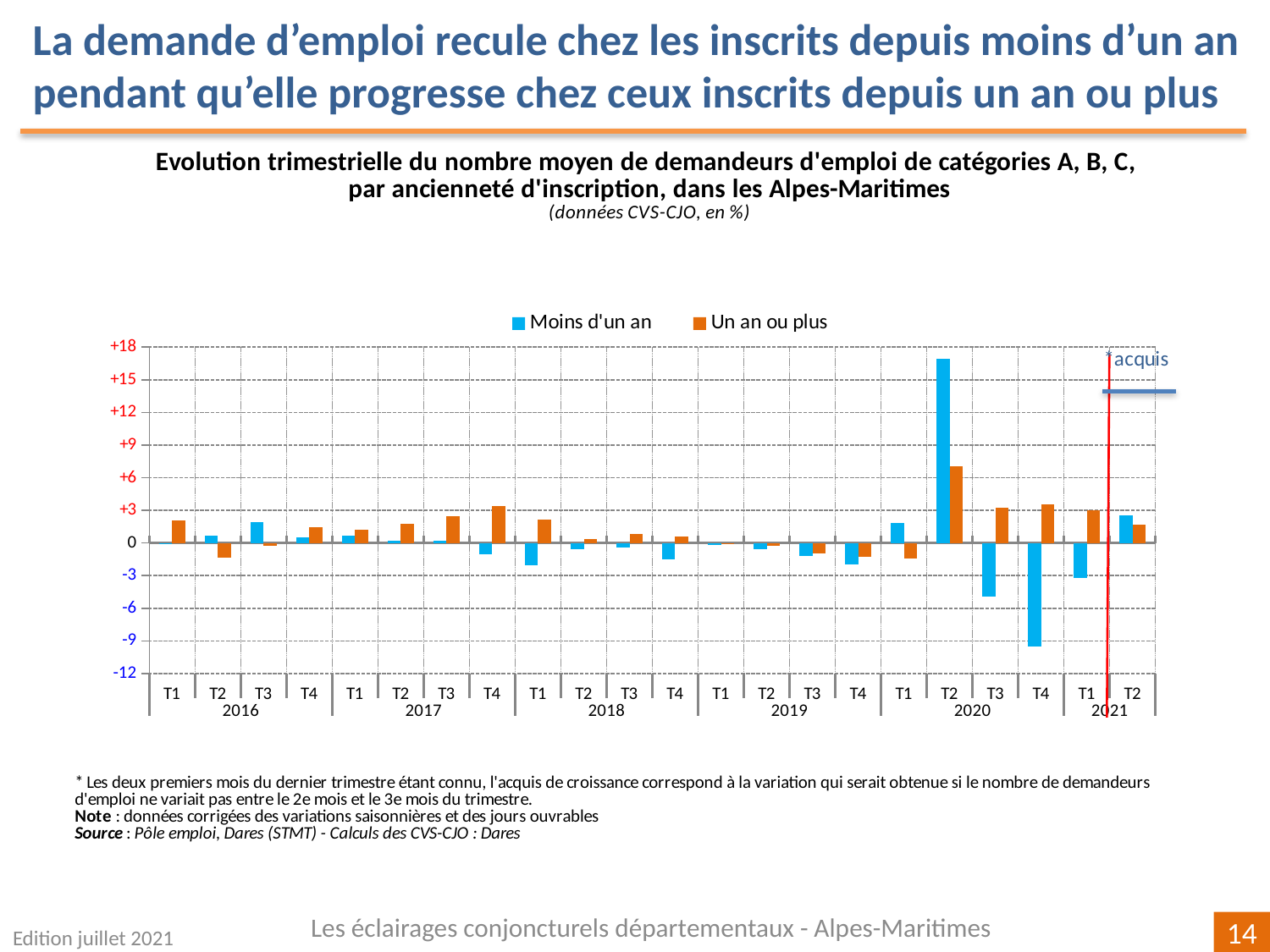
In which quarter is the value for 'Moins d'un an' lowest? T4 2020 What are the two series named in the legend? Moins d'un an; Un an ou plus Is the value for 'Moins d'un an' in T4 2020 greater or less than -6? less Is the value for 'Un an ou plus' in T2 2020 greater or less than +6? greater Is the value for 'Moins d'un an' in T2 2020 greater or less than +15? greater What kind of chart is shown on the slide? Bar chart In T4 2020, which series has the larger value, 'Moins d'un an' or 'Un an ou plus'? Un an ou plus In T2 2020, which series has the larger value, 'Moins d'un an' or 'Un an ou plus'? Moins d'un an In which quarter is the value for 'Moins d'un an' highest? T2 2020 How many series does the legend list? 2 How many quarters are plotted along the x axis? 22 In which quarter is the value for 'Un an ou plus' highest? T2 2020